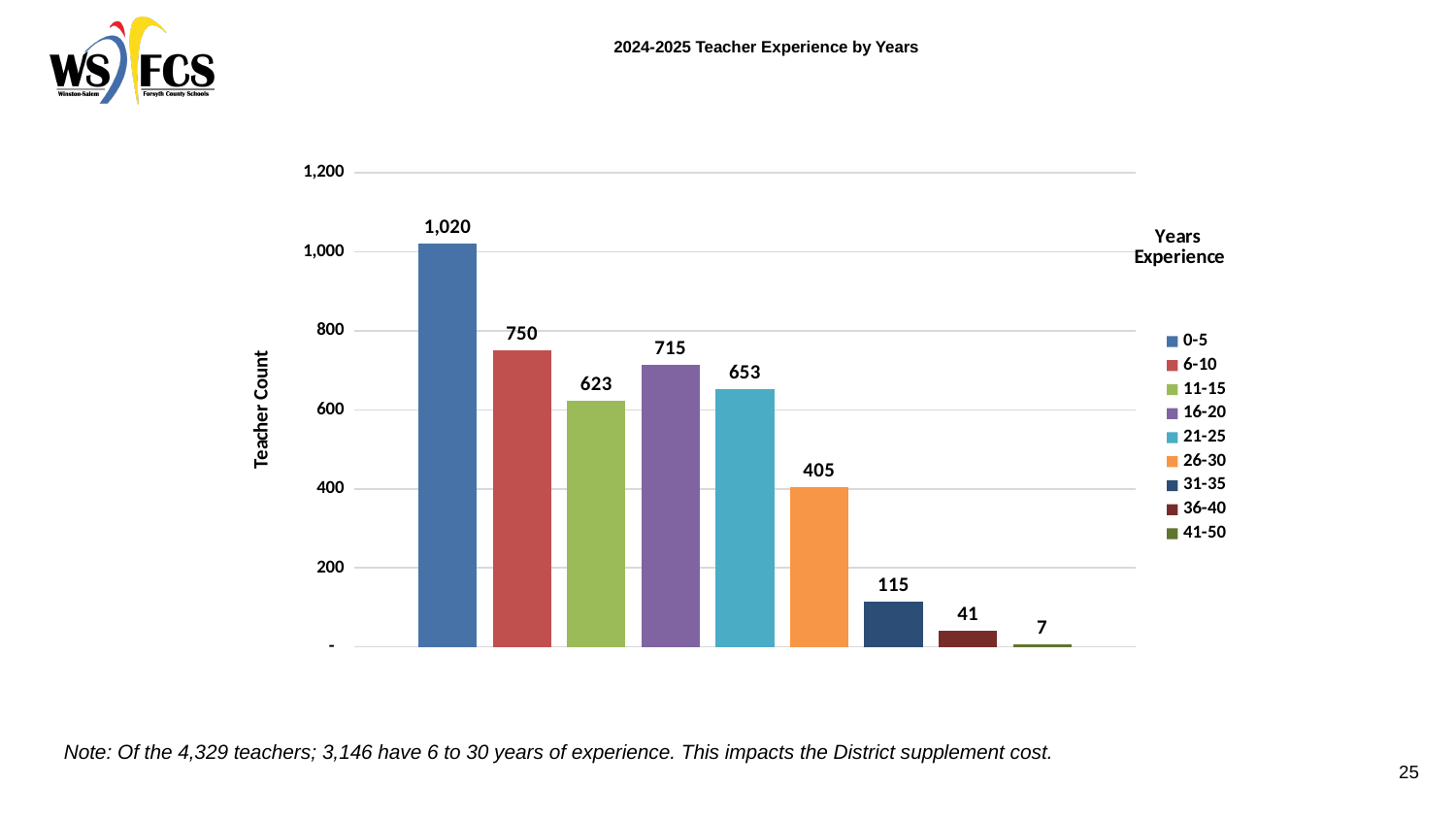
What is the difference in teacher count between the 6-10 and 11-15 categories? 127 What is the teacher count for the 26-30 years experience category? 405 What is the teacher count for the 41-50 years experience category? 7 Which years-of-experience category has the lowest teacher count? 41-50 Is the teacher count for the 31-35 category greater or less than 200? less Which category has a larger teacher count, 16-20 or 21-25? 16-20 What is the title of the chart? 2024-2025 Teacher Experience by Years Which years-of-experience category has the highest teacher count? 0-5 How many years-of-experience categories are shown in the chart? 9 What is the label on the vertical axis of the chart? Teacher Count What is the teacher count for the 0-5 years experience category? 1,020 What kind of chart is shown on the slide? bar chart